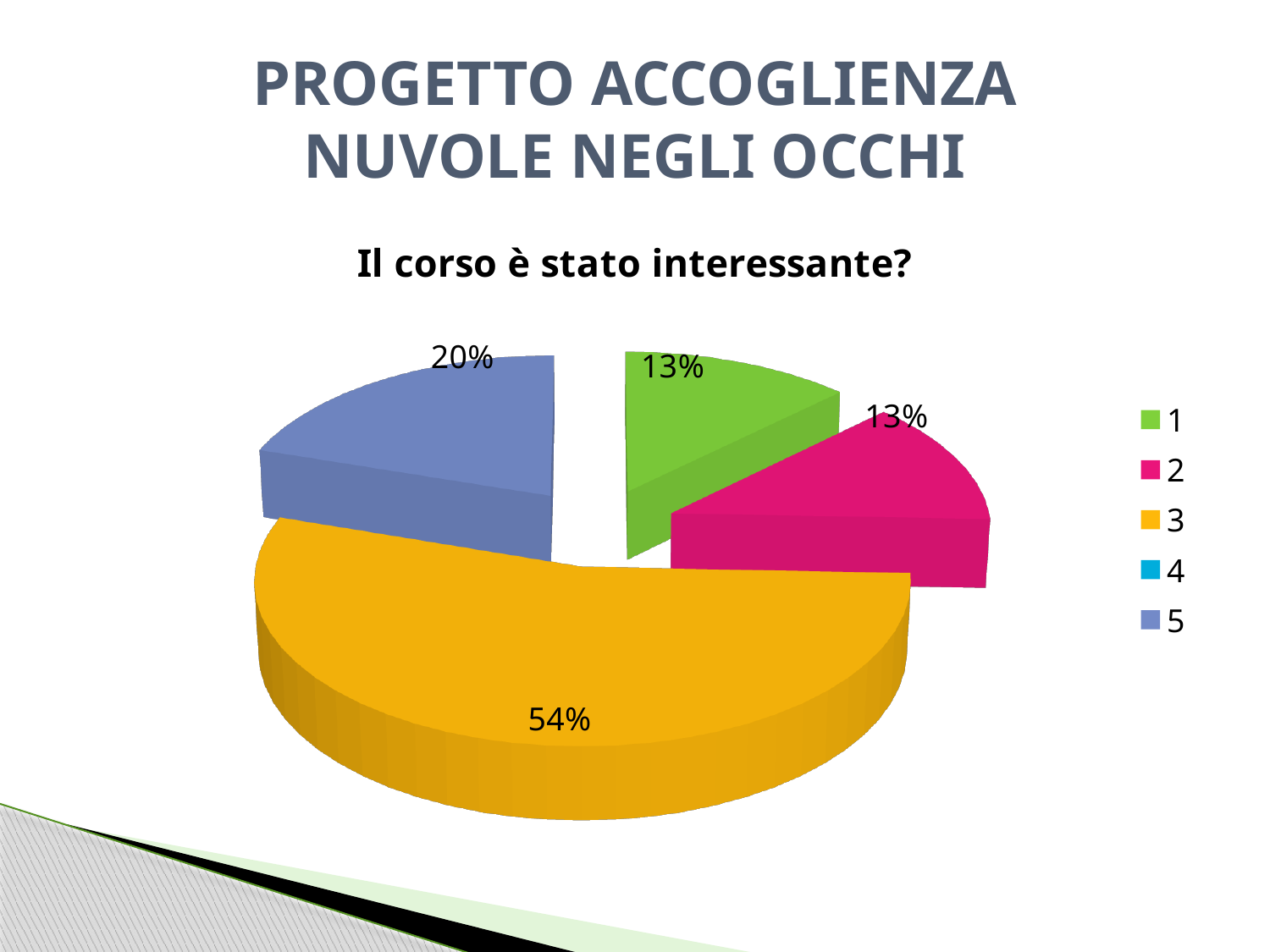
What share of the pie does category 3 have? 54% Which category has the largest slice of the pie? 3 What share of the pie does category 5 have? 20% Which is larger, the slice for category 5 or the slice for category 1? 5 What is the combined share of categories 1 and 2? 26% How many entries does the legend list? 5 What is the difference in percentage points between the slice for category 3 and the slice for category 5? 34 What share of the pie does category 1 have? 13% What colour is the slice for category 3? yellow What kind of chart is shown on the slide? pie chart What is the chart's title? Il corso è stato interessante?